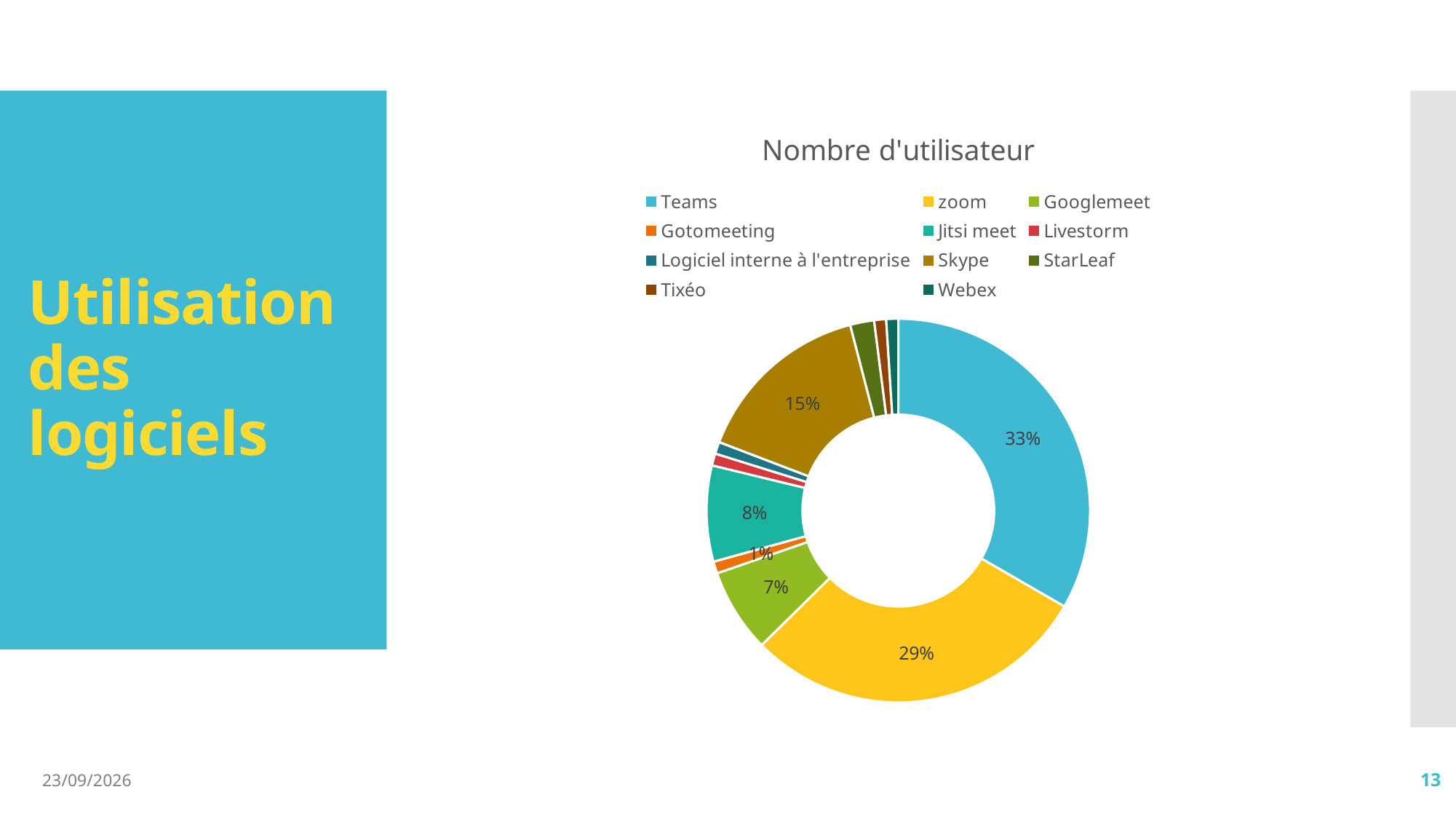
What is the title of the chart? Nombre d'utilisateur How many categories does the legend list? 11 What percentage is shown for Googlemeet? 7% Which has a larger share, zoom or Skype? zoom What percentage is shown for Jitsi meet? 8% What percentage is shown for Skype? 15% What percentage is shown for Gotomeeting? 1% Which software has the largest share of the chart? Teams What is the difference in percentage points between Teams and zoom? 4 percentage points What share of the chart does Teams represent? 33% What kind of chart is shown on the slide? Doughnut (pie) chart What percentage is shown for zoom? 29%